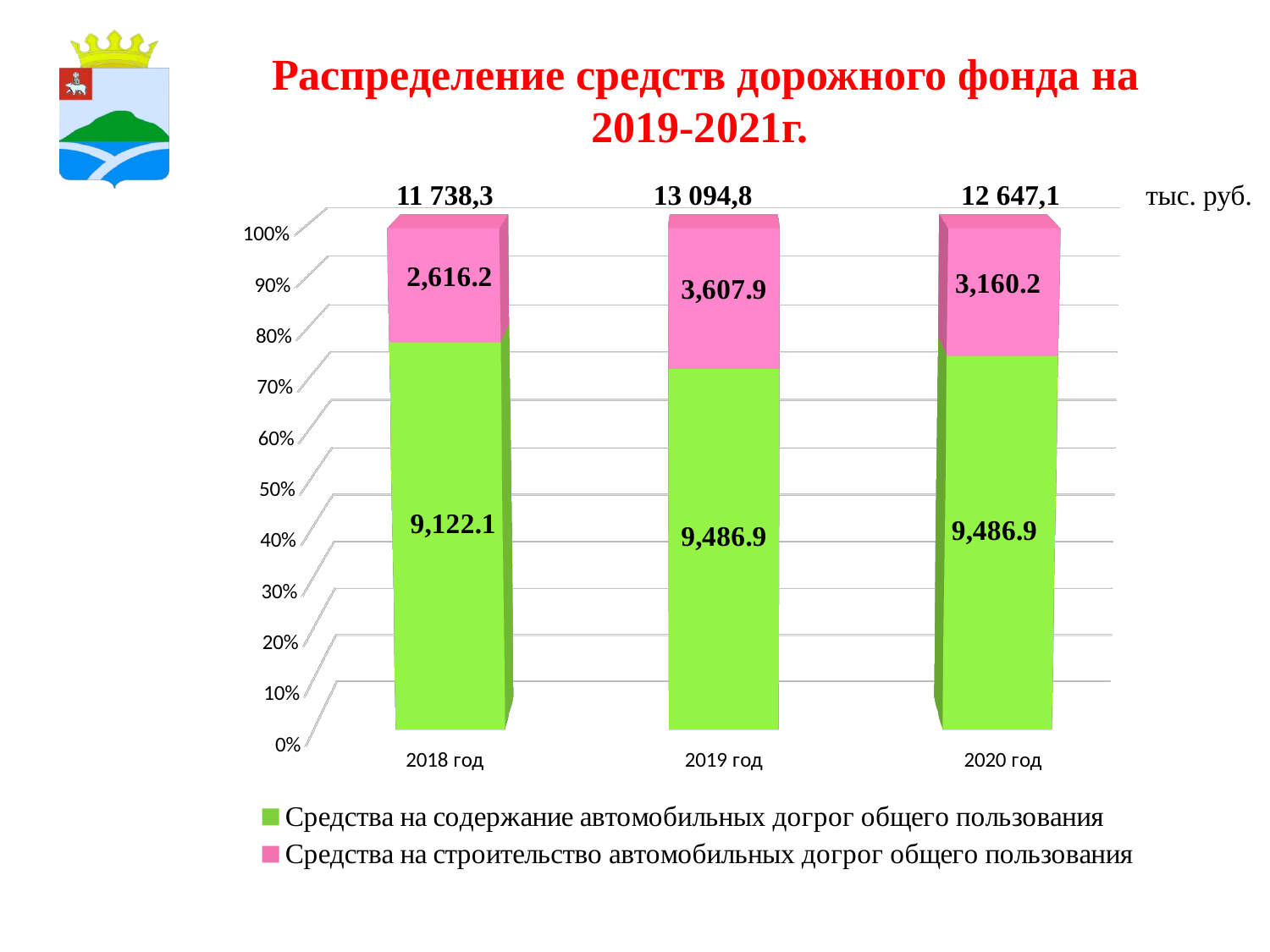
Which year has the highest value for 'Средства на строительство автомобильных догрог общего пользования'? 2019 год What total is printed above the bar for 2019 год? 13 094,8 How many years are shown on the x axis of the chart? 3 What is the value for 'Средства на содержание автомобильных догрог общего пользования' in 2018 год? 9,122.1 What is the difference between the maintenance values ('Средства на содержание') for 2019 год and 2018 год? 364.8 Which is larger: the construction value ('Средства на строительство') for 2020 год or for 2018 год? 2020 год Which year has the lowest value for 'Средства на строительство автомобильных догрог общего пользования'? 2018 год What is the value for 'Средства на строительство автомобильных догрог общего пользования' in 2019 год? 3,607.9 How many series does the legend list? 2 What kind of chart is shown on the slide? Stacked bar chart Is the share of the green segment ('Средства на содержание') in the 2018 год bar greater or less than 70%? greater What is the difference between the construction values ('Средства на строительство') for 2019 год and 2018 год? 991.7